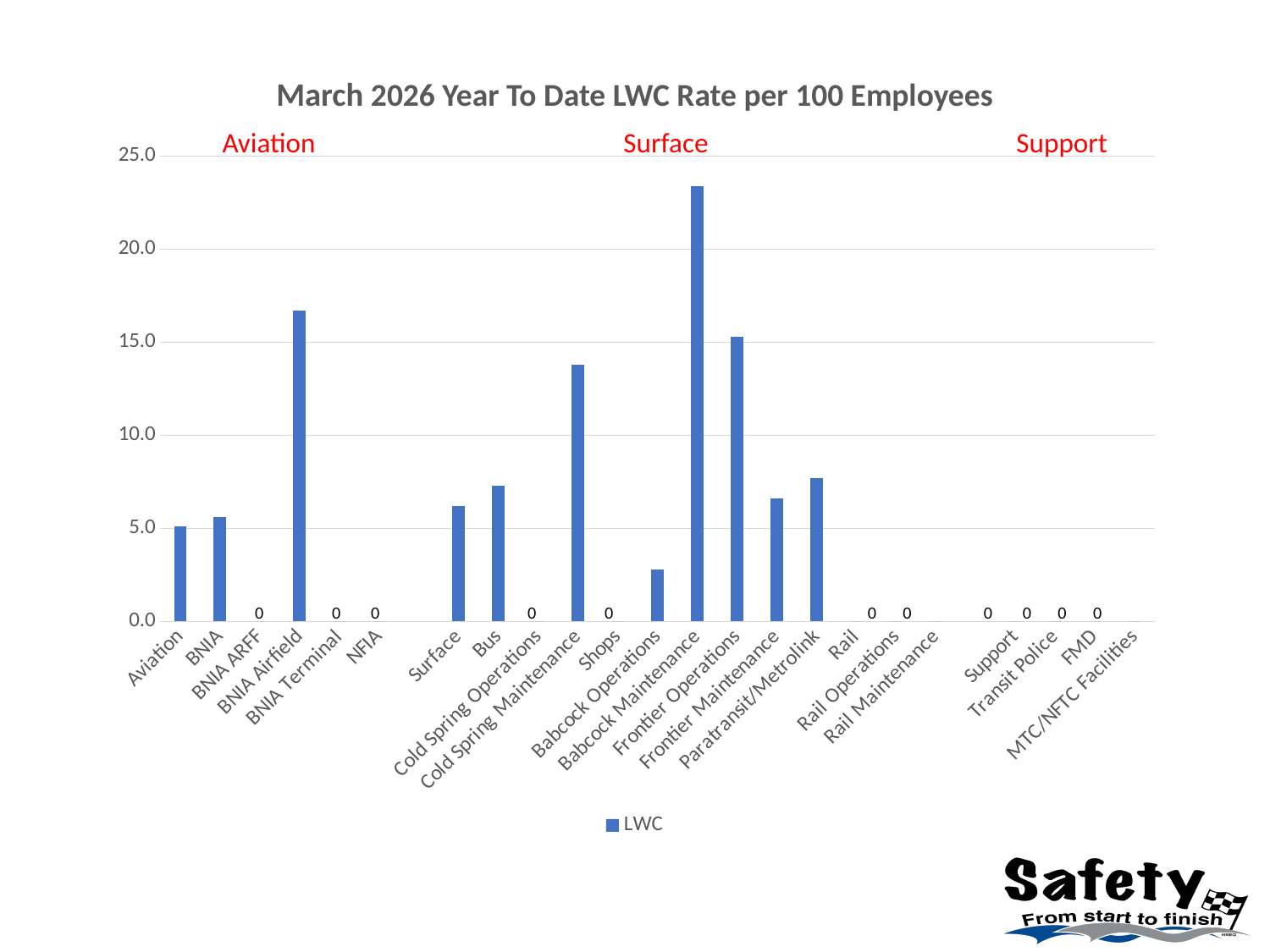
Is the value for Babcock Operations greater or less than 5.0? less What is the LWC rate for BNIA ARFF? 0 Is the value for Cold Spring Maintenance greater or less than 15.0? less What is the LWC rate for Shops? 0 What is the title of the chart? March 2026 Year To Date LWC Rate per 100 Employees Which category has the highest LWC rate? Babcock Maintenance Which is larger, the value for Cold Spring Maintenance or the value for Bus? Cold Spring Maintenance Is the value for Babcock Maintenance greater or less than 20.0? greater What are the three red group labels shown above the chart? Aviation, Surface, Support How many series does the legend list? 1 What is the LWC rate for Transit Police? 0 What kind of chart is shown on the slide? bar chart